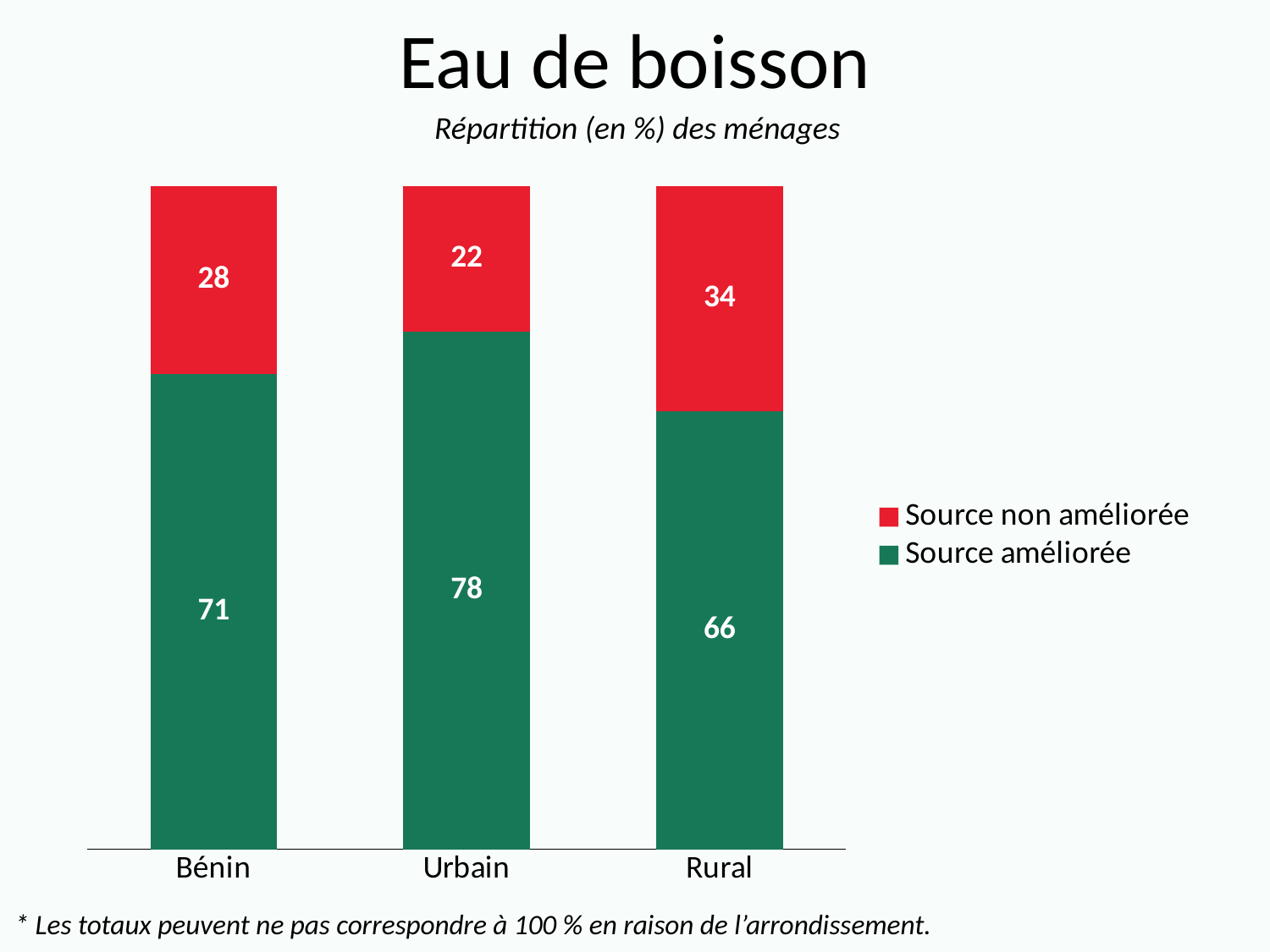
What is the difference between the Source améliorée values for Urbain and Rural? 12 Which category has the highest value for Source améliorée? Urbain What is the value for Source améliorée in Bénin? 71 What is the value for Source non améliorée in Bénin? 28 What is the value for Source non améliorée in Rural? 34 Which is larger: Source non améliorée in Rural or in Bénin? Rural What kind of chart is shown? Stacked bar chart Which category has the lowest value for Source non améliorée? Urbain How many categories are shown on the x axis? 3 What is the title of the chart? Eau de boisson How many series does the legend list? 2 What is the value for Source améliorée in Urbain? 78